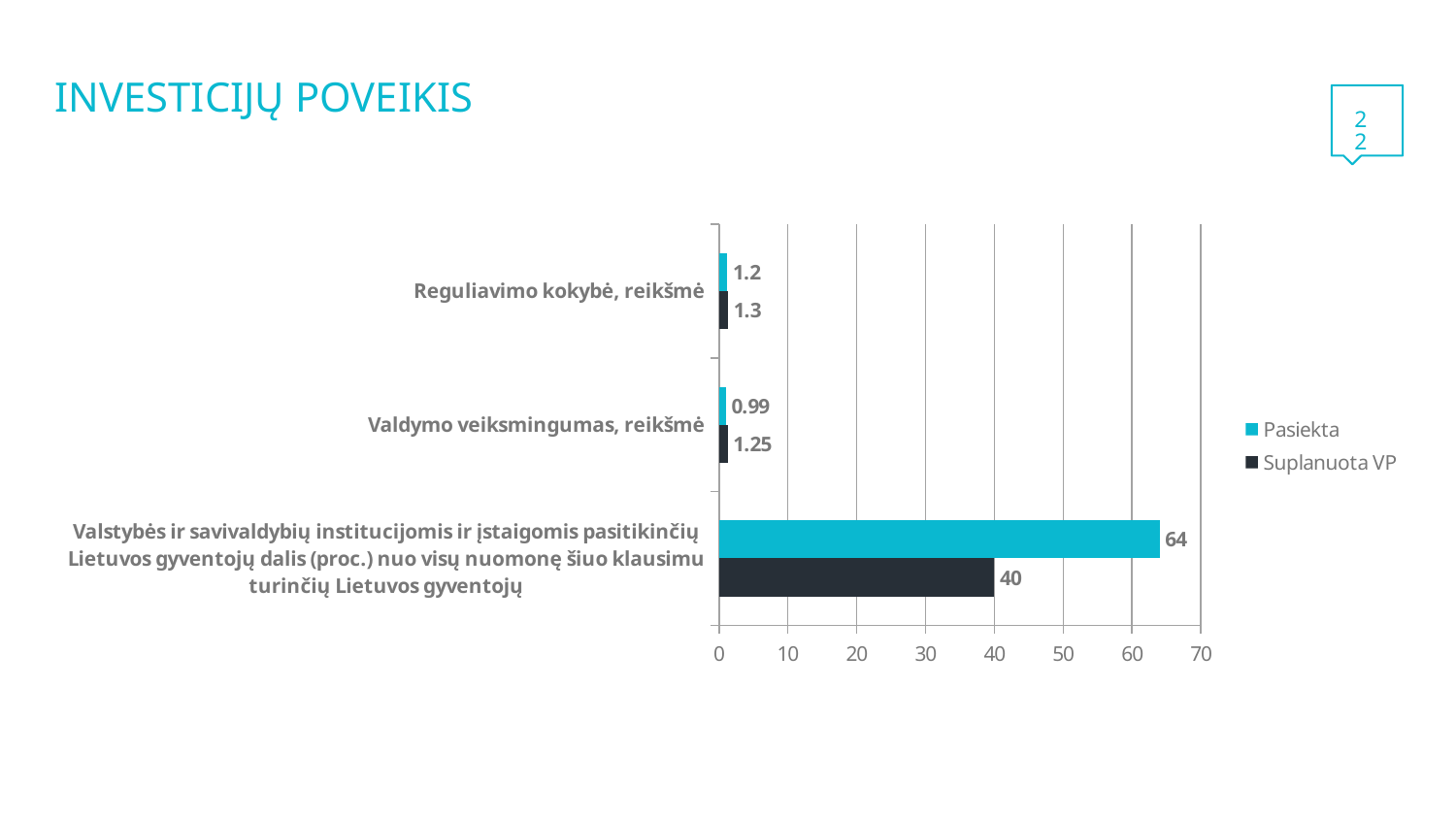
How many categories are shown on the chart? 3 What is the Pasiekta value for the category about Lietuvos gyventojų dalis (proc.) trusting state and municipal institutions? 64 How many series does the legend list? 2 Which category has the highest Pasiekta value? Valstybės ir savivaldybių institucijomis ir įstaigomis pasitikinčių Lietuvos gyventojų dalis (proc.) nuo visų nuomonę šiuo klausimu turinčių Lietuvos gyventojų Is the Suplanuota VP value for the category about Lietuvos gyventojų dalis (proc.) greater or less than 50? less What is the Suplanuota VP value for Valdymo veiksmingumas, reikšmė? 1.25 What is the Pasiekta value for Reguliavimo kokybė, reikšmė? 1.2 What is the Suplanuota VP value for Reguliavimo kokybė, reikšmė? 1.3 What is the difference between the Pasiekta and Suplanuota VP values for the category about Lietuvos gyventojų dalis (proc.)? 24 For Valdymo veiksmingumas, reikšmė, which is larger: Pasiekta or Suplanuota VP? Suplanuota VP What kind of chart is shown on the slide? bar chart Which category has the lowest Pasiekta value? Valdymo veiksmingumas, reikšmė